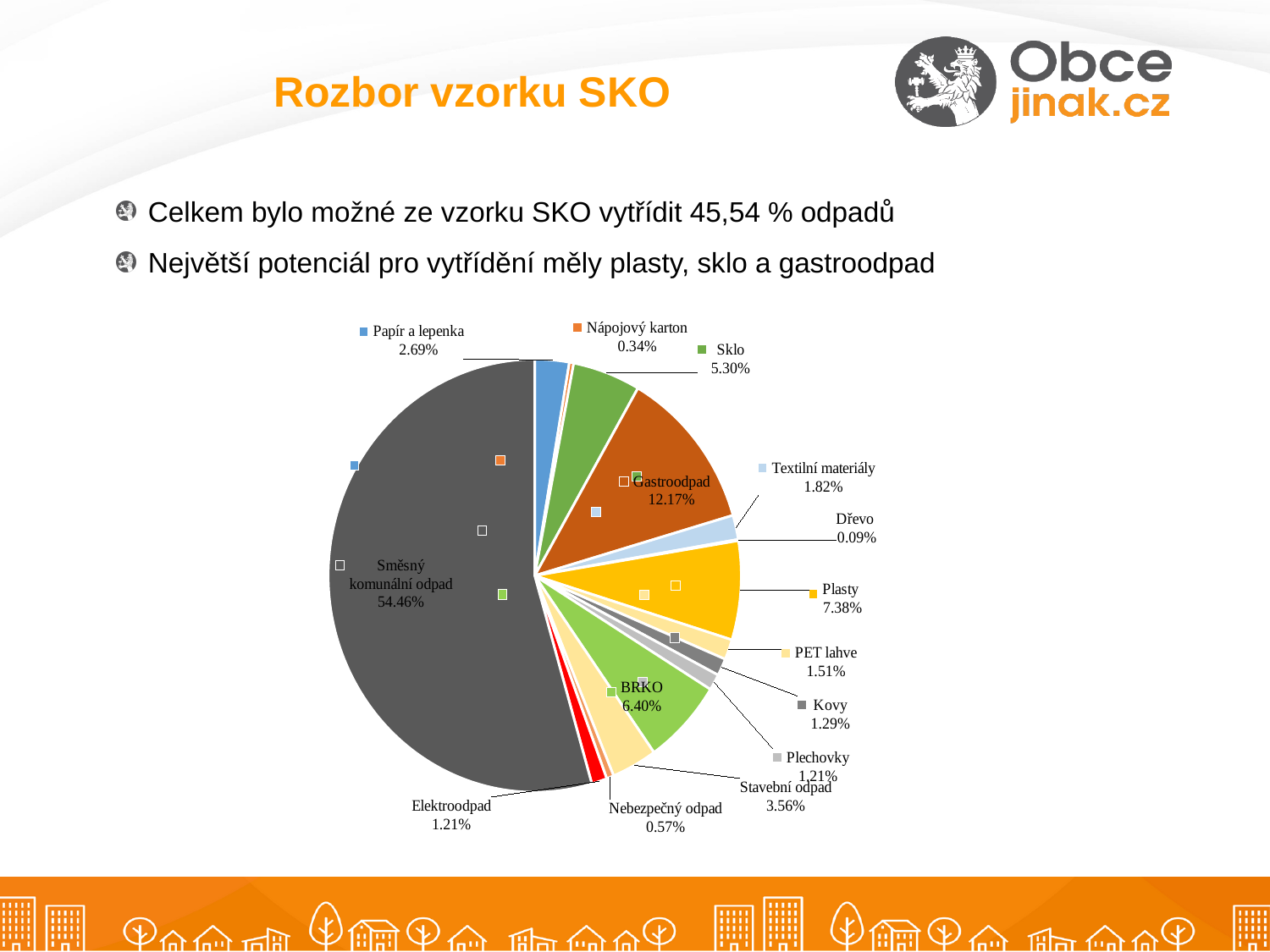
What is the value shown for Gastroodpad? 12.17% How many categories (slices) does the pie chart have? 15 What is the value shown for Sklo? 5.30% What is the value shown for Stavební odpad? 3.56% Which category has the largest slice of the pie? Směsný komunální odpad Which category has the smallest slice of the pie? Dřevo What is the difference between the values for Gastroodpad and Plasty? 4.79% What is the value shown for Plasty? 7.38% What share of the pie does Směsný komunální odpad represent? 54.46% What kind of chart is shown on the slide? pie chart Which is larger, the value for BRKO or the value for Sklo? BRKO What is the value shown for Nebezpečný odpad? 0.57%